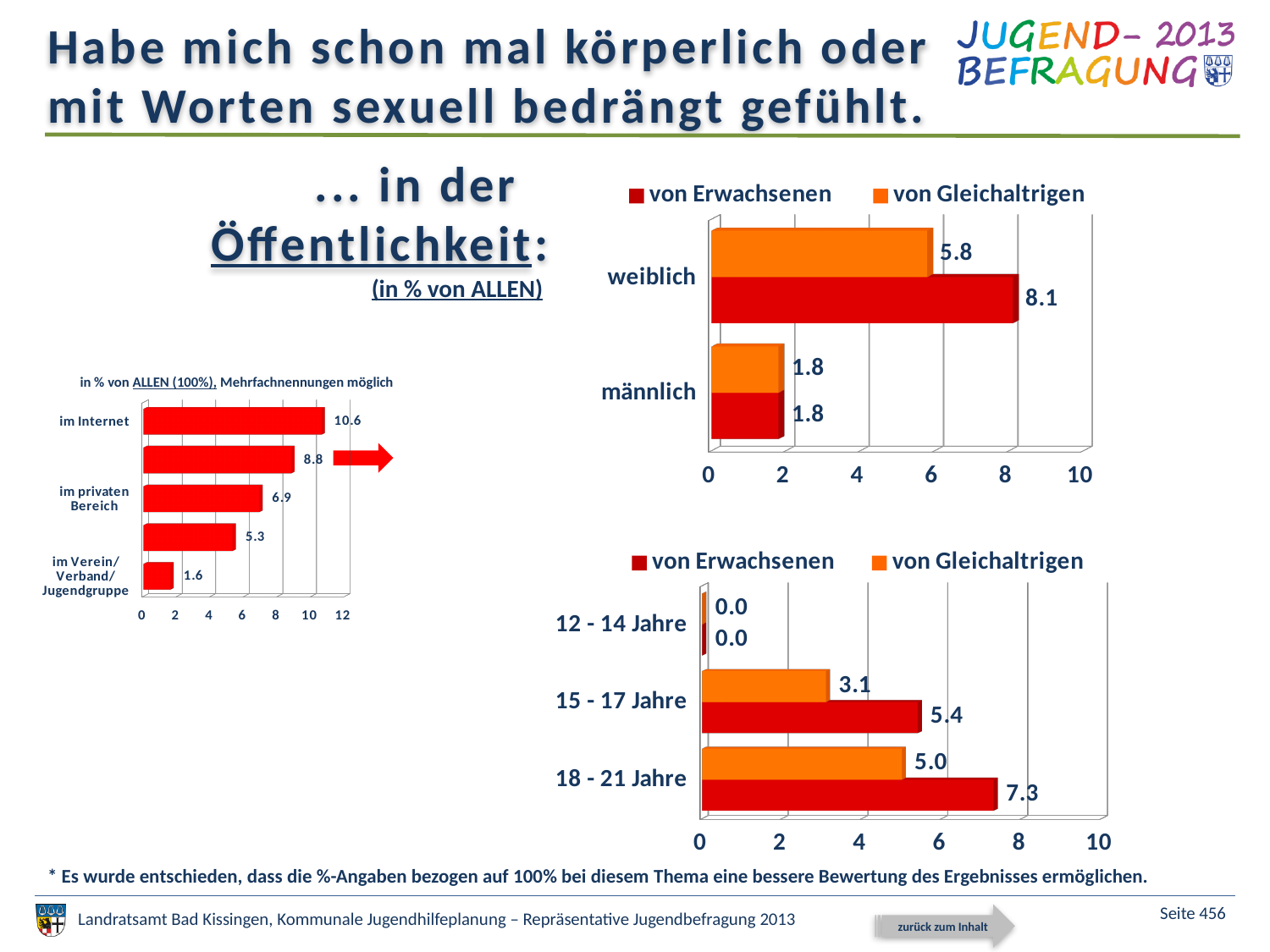
In the bottom-right chart (age groups), how many age groups are shown? 3 In the bottom-right chart (age groups), what is the value for 15 - 17 Jahre in the 'von Gleichaltrigen' series? 3.1 In the top-right chart (weiblich/männlich), what is the difference between the 'von Erwachsenen' and 'von Gleichaltrigen' values for weiblich? 2.3 In the top-right chart (weiblich/männlich), how many series does the legend list? 2 In the top-right chart (weiblich/männlich), what is the value for männlich in the 'von Erwachsenen' series? 1.8 In the bottom-right chart (age groups), what is the value for 18 - 21 Jahre in the 'von Erwachsenen' series? 7.3 In the top-right chart (weiblich/männlich), what is the value for weiblich in the 'von Erwachsenen' series? 8.1 In the top-right chart (weiblich/männlich), what is the value for weiblich in the 'von Gleichaltrigen' series? 5.8 In the bottom-left chart, what is the value for 'im Internet'? 10.6 In the bottom-left chart, what is the value for 'im Verein/Verband/Jugendgruppe'? 1.6 In the bottom-right chart (age groups), which age group has the lowest 'von Gleichaltrigen' value? 12 - 14 Jahre In the bottom-right chart (age groups), which age group has the highest 'von Erwachsenen' value? 18 - 21 Jahre